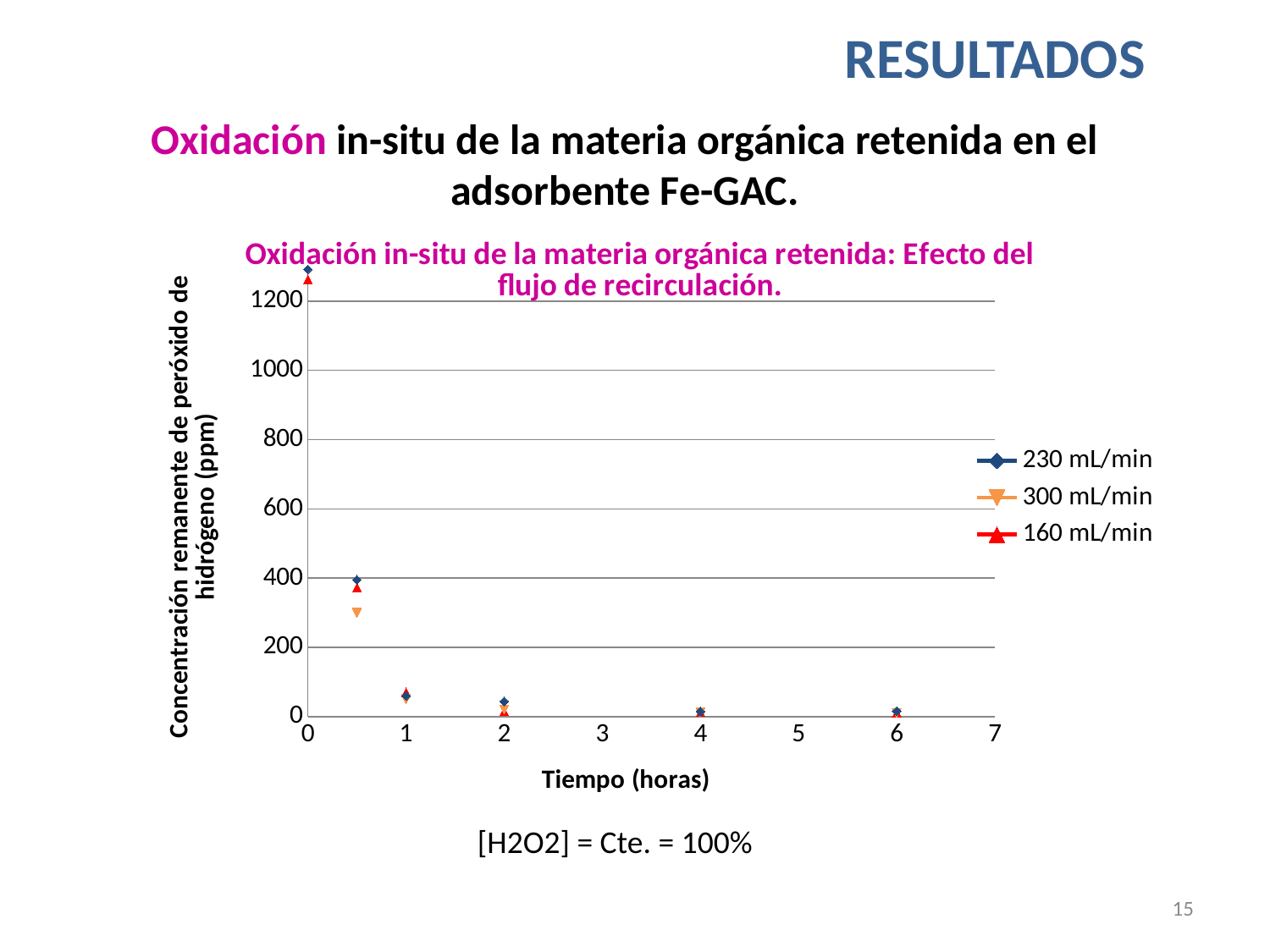
Is the value for 230 mL/min at 0.5 hours greater or less than 200? greater At 0.5 hours, which series has the higher value: 230 mL/min or 300 mL/min? 230 mL/min What are the three series named in the chart legend? 230 mL/min, 300 mL/min, 160 mL/min Is the value for 230 mL/min at 1 hour greater or less than 200? less At which time is the value for 160 mL/min highest? 0 Is the value for 300 mL/min at 0.5 hours greater or less than 400? less How many time points are plotted for each series? 6 What is the label of the x axis of the chart? Tiempo (horas) How many series does the chart legend list? 3 Do the values for 230 mL/min rise or fall as time increases along the x axis? fall